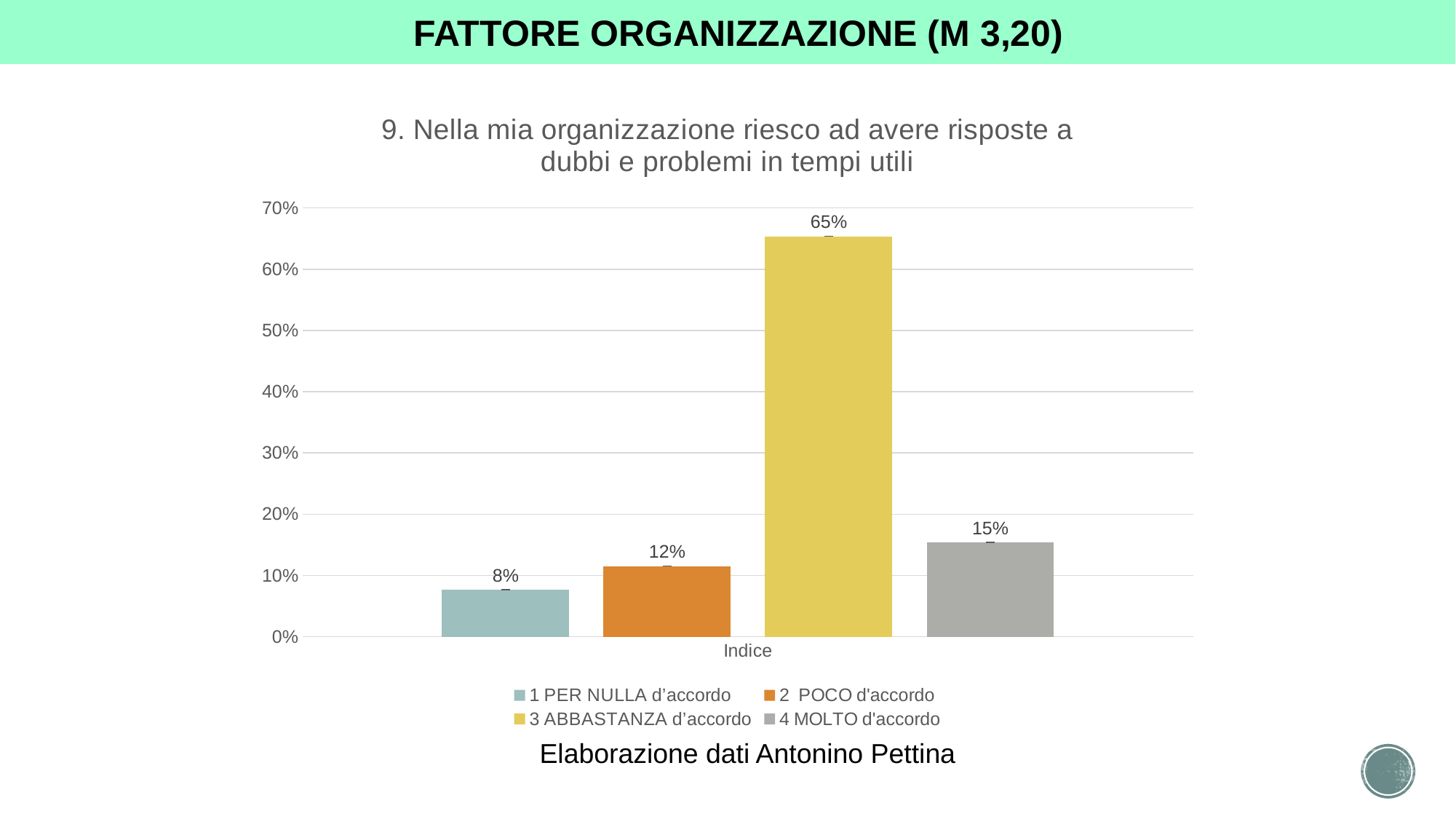
Which response category has the lowest percentage? 1 PER NULLA d'accordo Is the value for '3 ABBASTANZA d'accordo' greater or less than 60%? greater What is the difference between the percentages for '3 ABBASTANZA d'accordo' and '4 MOLTO d'accordo'? 50% What percentage is shown for '4 MOLTO d'accordo'? 15% What percentage is shown for '2 POCO d'accordo'? 12% What percentage is shown for '1 PER NULLA d'accordo'? 8% Which is larger, the value for '2 POCO d'accordo' or the value for '4 MOLTO d'accordo'? 4 MOLTO d'accordo What kind of chart is shown on the slide? Bar chart What is the title of the chart? 9. Nella mia organizzazione riesco ad avere risposte a dubbi e problemi in tempi utili How many series does the legend list? 4 What percentage is shown for '3 ABBASTANZA d'accordo'? 65% Which response category has the highest percentage? 3 ABBASTANZA d'accordo